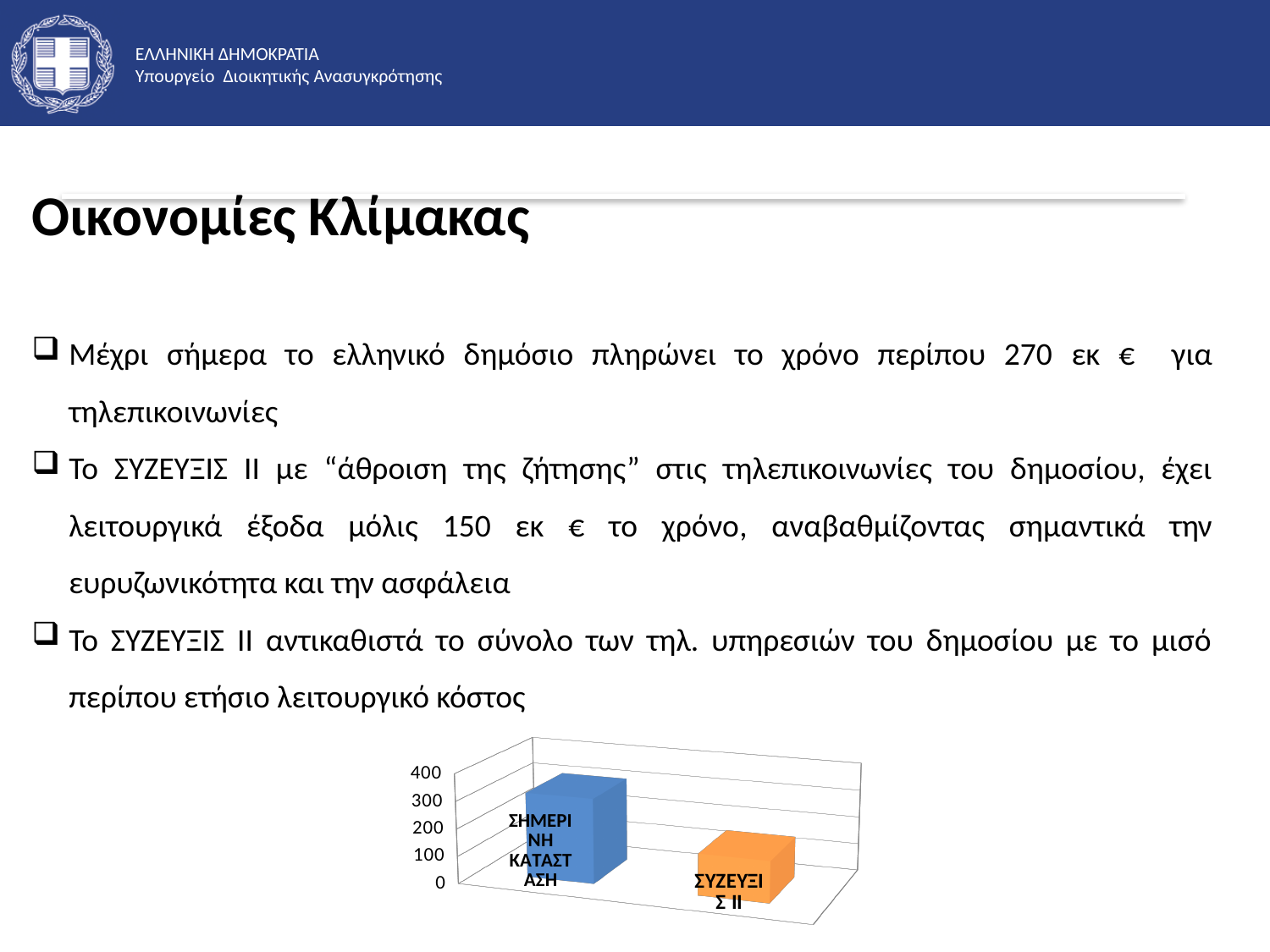
Is the value for ΣΥΖΕΥΞΙΣ ΙΙ greater or less than 200? less What colour is the bar for ΣΥΖΕΥΞΙΣ ΙΙ? orange Do the bar values rise or fall from left to right across the chart? fall How many categories (bars) does the chart show? 2 Is the value for ΣΗΜΕΡΙΝΗ ΚΑΤΑΣΤΑΣΗ greater or less than 200? greater Which category has the lowest bar in the chart? ΣΥΖΕΥΞΙΣ ΙΙ Is the value for ΣΥΖΕΥΞΙΣ ΙΙ greater or less than 300? less What is the highest value shown on the chart's vertical axis? 400 Which is larger, the bar for ΣΗΜΕΡΙΝΗ ΚΑΤΑΣΤΑΣΗ or the bar for ΣΥΖΕΥΞΙΣ ΙΙ? ΣΗΜΕΡΙΝΗ ΚΑΤΑΣΤΑΣΗ What kind of chart is shown on the slide? bar chart Which category has the highest bar in the chart? ΣΗΜΕΡΙΝΗ ΚΑΤΑΣΤΑΣΗ